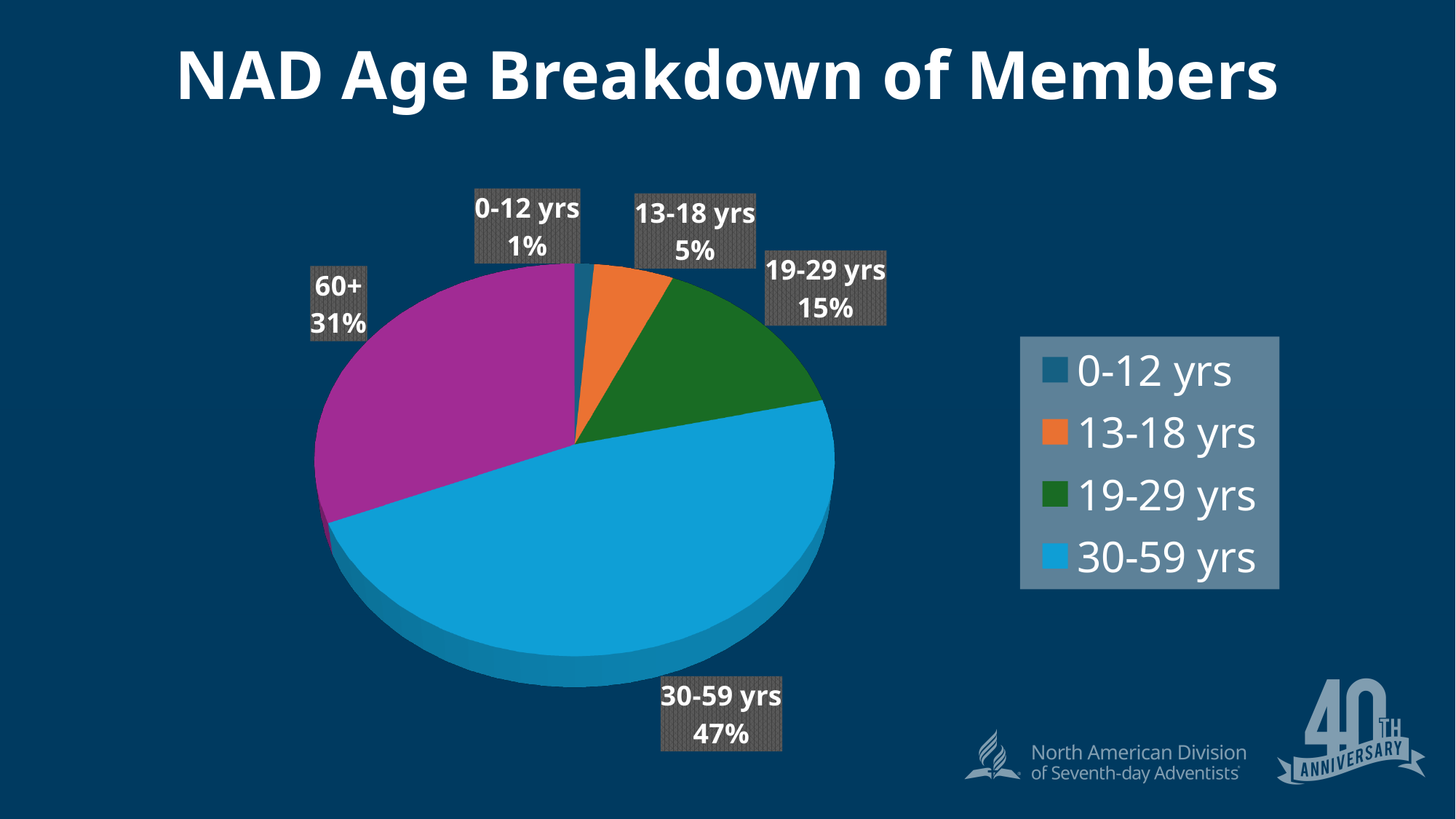
How many age groups are shown in the pie chart? 5 What is the difference in percentage points between the 30-59 yrs and 60+ groups? 16 What kind of chart is shown on the slide? Pie chart What share of members are aged 19-29 yrs? 15% Which age group has the smallest share of members? 0-12 yrs Which group has a larger share, 13-18 yrs or 19-29 yrs? 19-29 yrs Which age group has the largest share of members? 30-59 yrs What percentage of members are 60+? 31% What share of members are aged 30-59 yrs? 47% What percentage of members are aged 0-12 yrs? 1% What colour is the 60+ slice of the pie? Purple What is the title of the chart? NAD Age Breakdown of Members